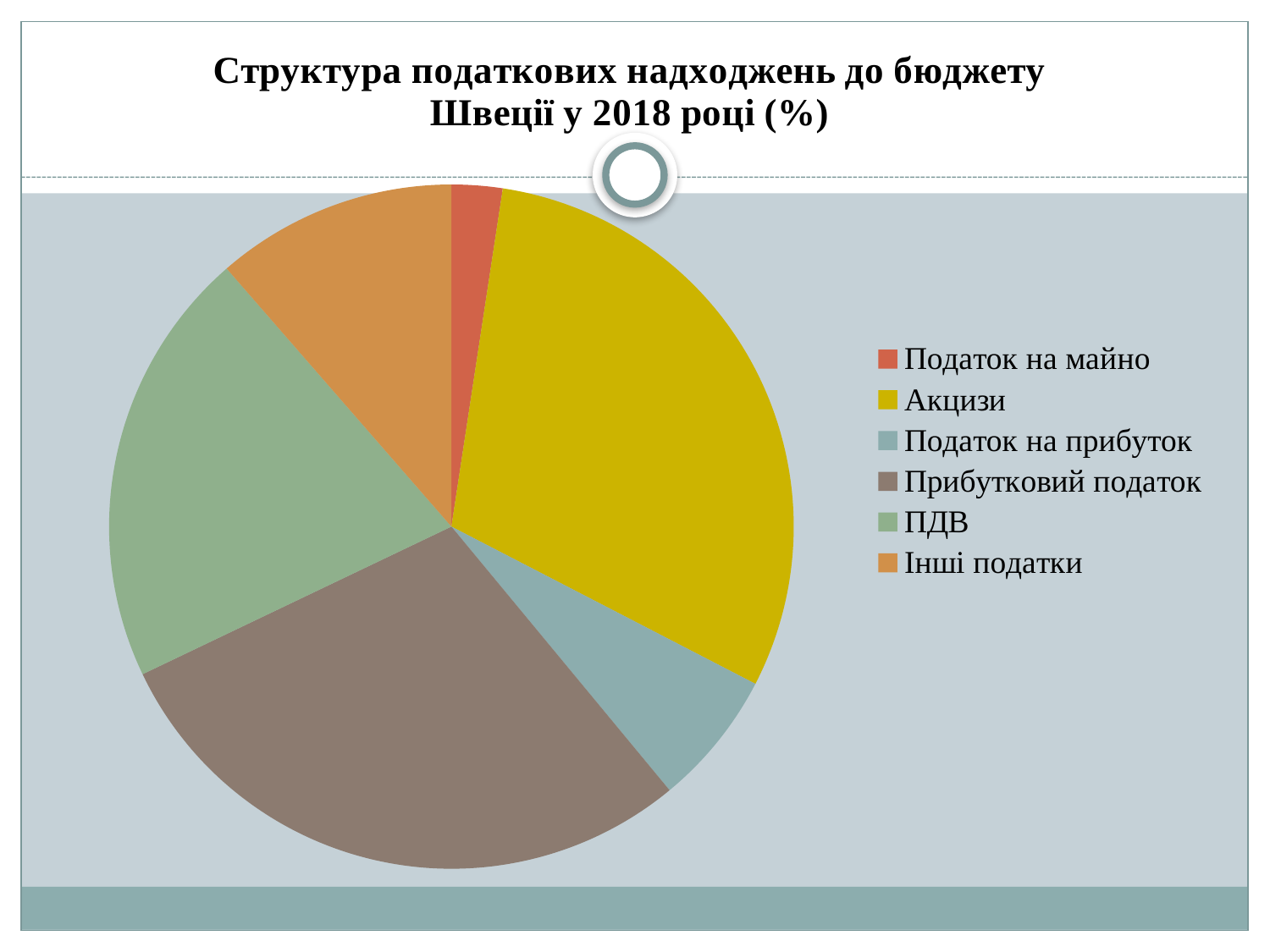
Which slice is larger: ПДВ or Інші податки? ПДВ Which slice is larger: Прибутковий податок or Податок на прибуток? Прибутковий податок How many categories (slices) does the pie chart have? 6 What kind of chart is shown on the slide? pie chart Which slice is larger: Податок на прибуток or Податок на майно? Податок на прибуток Which category has the smallest slice of the pie? Податок на майно Which category is shown in yellow in the legend? Акцизи Which category has the largest slice of the pie? Акцизи What is the title of the chart? Структура податкових надходжень до бюджету Швеції у 2018 році (%)